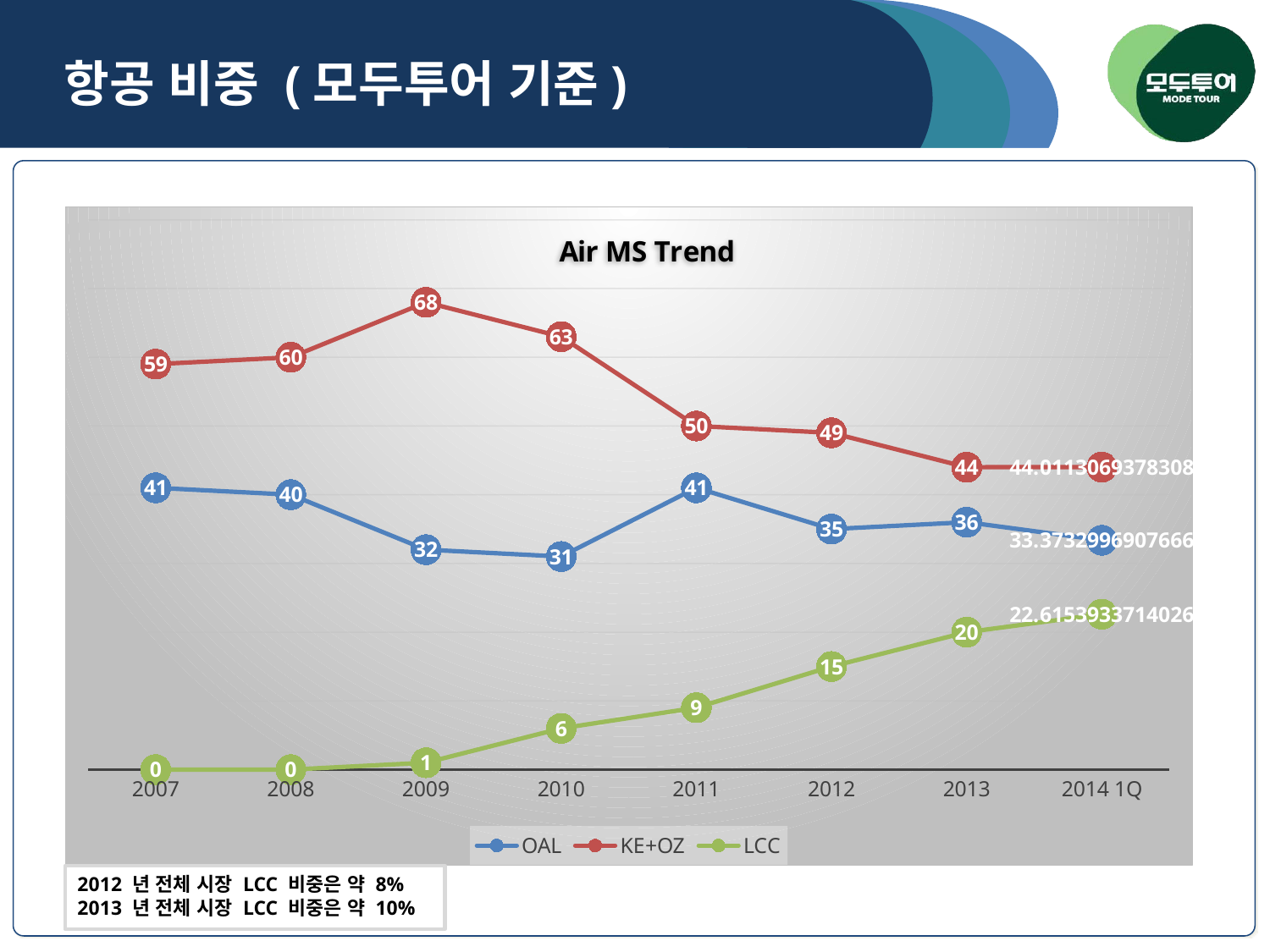
What is the value for LCC in 2013? 20 How many time points are plotted on the x axis? 8 Which is larger in 2012, the OAL value or the LCC value? OAL In which year does KE+OZ reach its highest value? 2009 What kind of chart is shown? Line chart What is the value for LCC in 2014 1Q? 22.6153933714026 How many series does the legend list? 3 What is the difference between the KE+OZ value and the OAL value in 2011? 9 Does the LCC series rise or fall from 2009 to 2013? Rise What is the value for OAL in 2010? 31 In which year is the OAL value lowest? 2010 What is the value for KE+OZ in 2009? 68